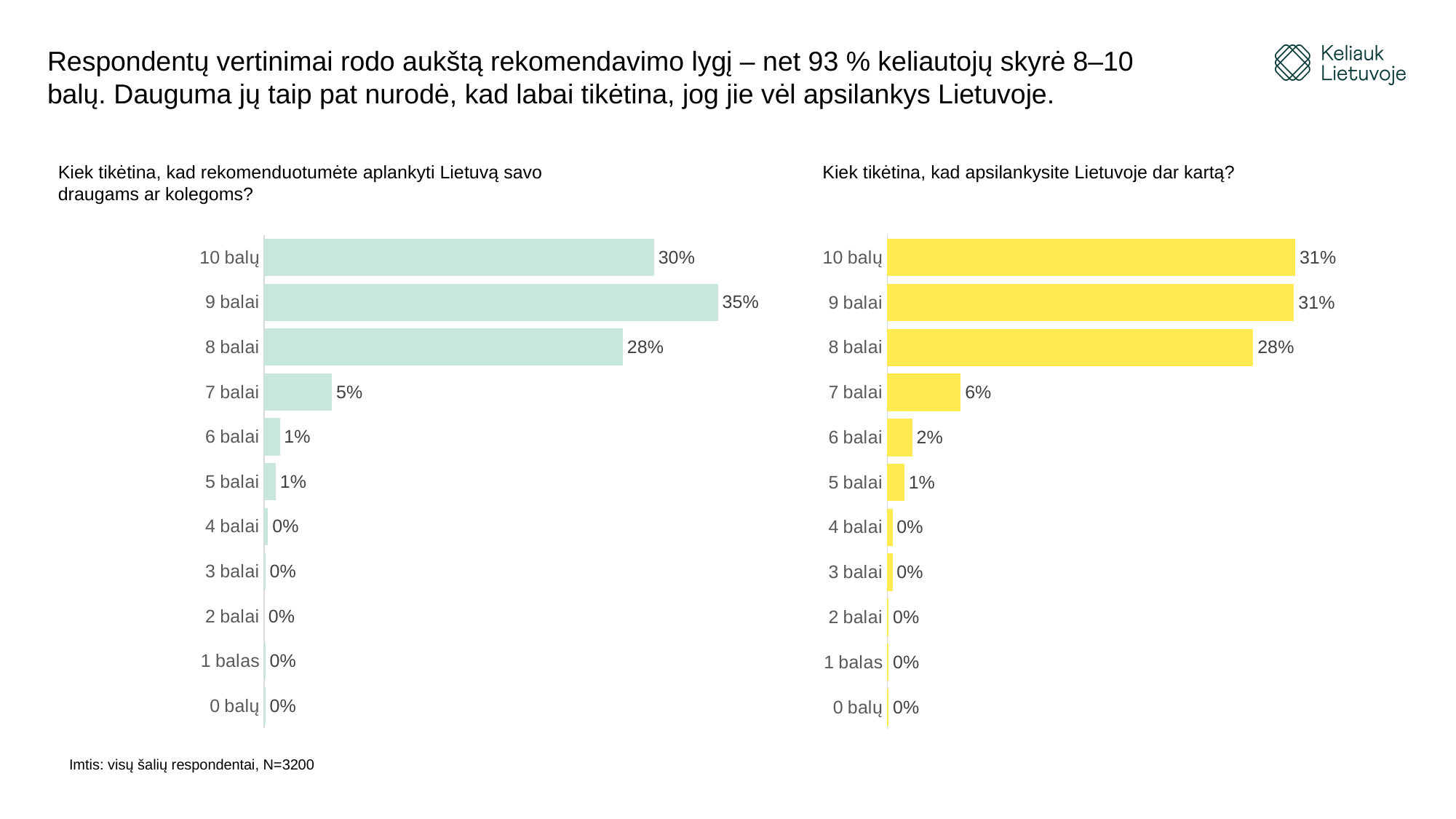
In the right chart (Kiek tikėtina, kad apsilankysite Lietuvoje dar kartą?), what is the value for 7 balai? 6% In the left chart (Kiek tikėtina, kad rekomenduotumėte aplankyti Lietuvą savo draugams ar kolegoms?), what is the difference between the values for 9 balai and 10 balų? 5% What kind of chart is the right chart (Kiek tikėtina, kad apsilankysite Lietuvoje dar kartą?)? Bar chart In the right chart (Kiek tikėtina, kad apsilankysite Lietuvoje dar kartą?), what is the value for 6 balai? 2% In the right chart (Kiek tikėtina, kad apsilankysite Lietuvoje dar kartą?), which is larger: the value for 8 balai or the value for 7 balai? 8 balai In the right chart (Kiek tikėtina, kad apsilankysite Lietuvoje dar kartą?), what is the difference between the values for 9 balai and 8 balai? 3% How many categories are shown in the left chart (Kiek tikėtina, kad rekomenduotumėte aplankyti Lietuvą savo draugams ar kolegoms?)? 11 In the right chart (Kiek tikėtina, kad apsilankysite Lietuvoje dar kartą?), what is the value for 10 balų? 31% In the left chart (Kiek tikėtina, kad rekomenduotumėte aplankyti Lietuvą savo draugams ar kolegoms?), which category has the highest value? 9 balai In the left chart (Kiek tikėtina, kad rekomenduotumėte aplankyti Lietuvą savo draugams ar kolegoms?), what is the value for 7 balai? 5% What colour are the bars in the left chart (Kiek tikėtina, kad rekomenduotumėte aplankyti Lietuvą savo draugams ar kolegoms?)? Light green In the left chart (Kiek tikėtina, kad rekomenduotumėte aplankyti Lietuvą savo draugams ar kolegoms?), what is the value for 9 balai? 35%